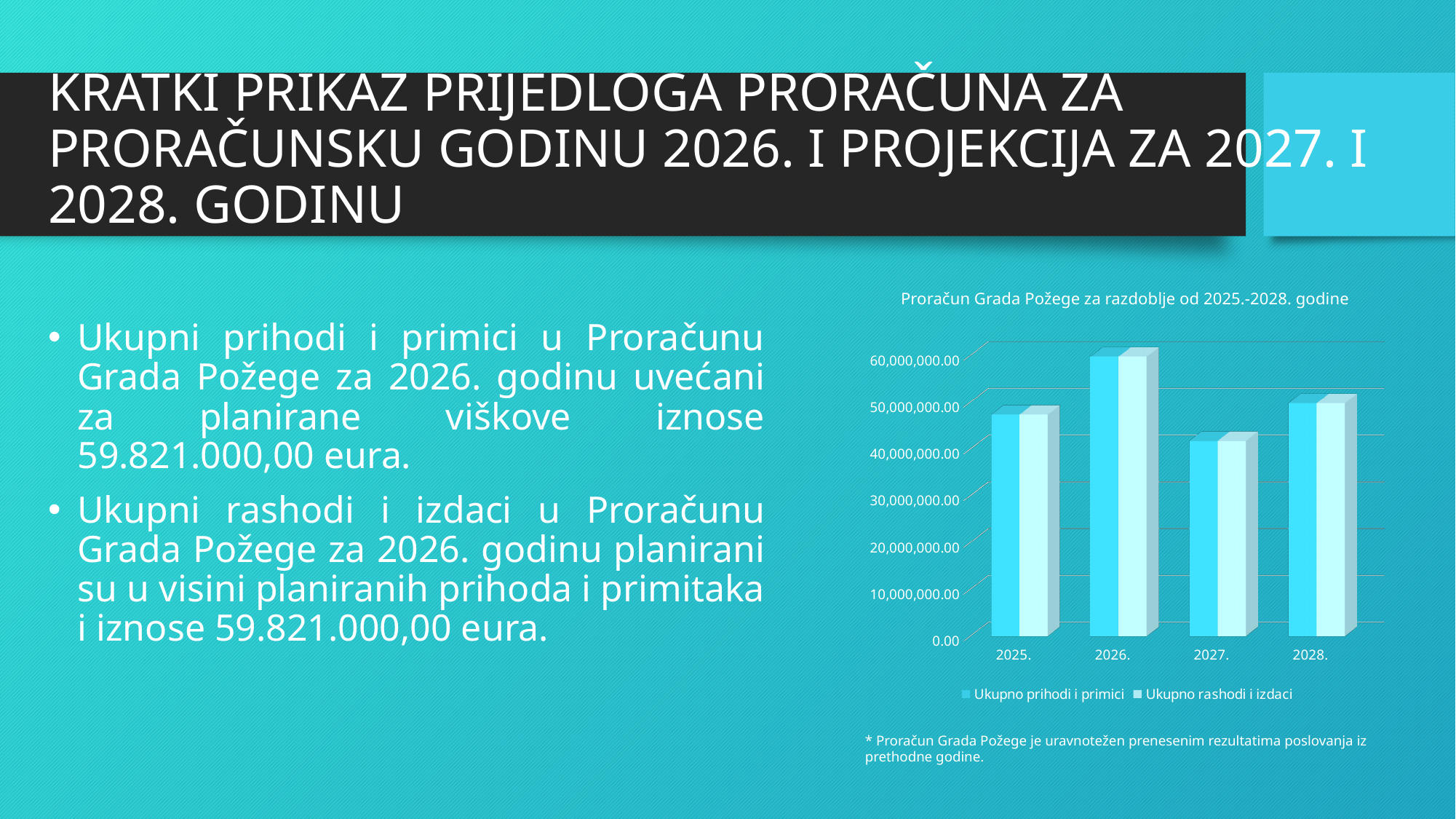
Is the value for Ukupno rashodi i izdaci in 2028. greater or less than 40,000,000.00? greater Which year has the lowest bars in the chart? 2027. Is the value for Ukupno rashodi i izdaci in 2026. greater or less than 50,000,000.00? greater What kind of chart is shown on the slide? bar chart How many years (categories) are shown on the x axis of the chart? 4 Which year has a larger value for Ukupno prihodi i primici, 2026. or 2027.? 2026. Is the value for Ukupno prihodi i primici in 2025. greater or less than 40,000,000.00? greater How many series does the chart legend list? 2 What is the title of the chart? Proračun Grada Požege za razdoblje od 2025.-2028. godine Do the values rise or fall from 2026. to 2027. in the chart? fall Which year has the highest bars in the chart? 2026.